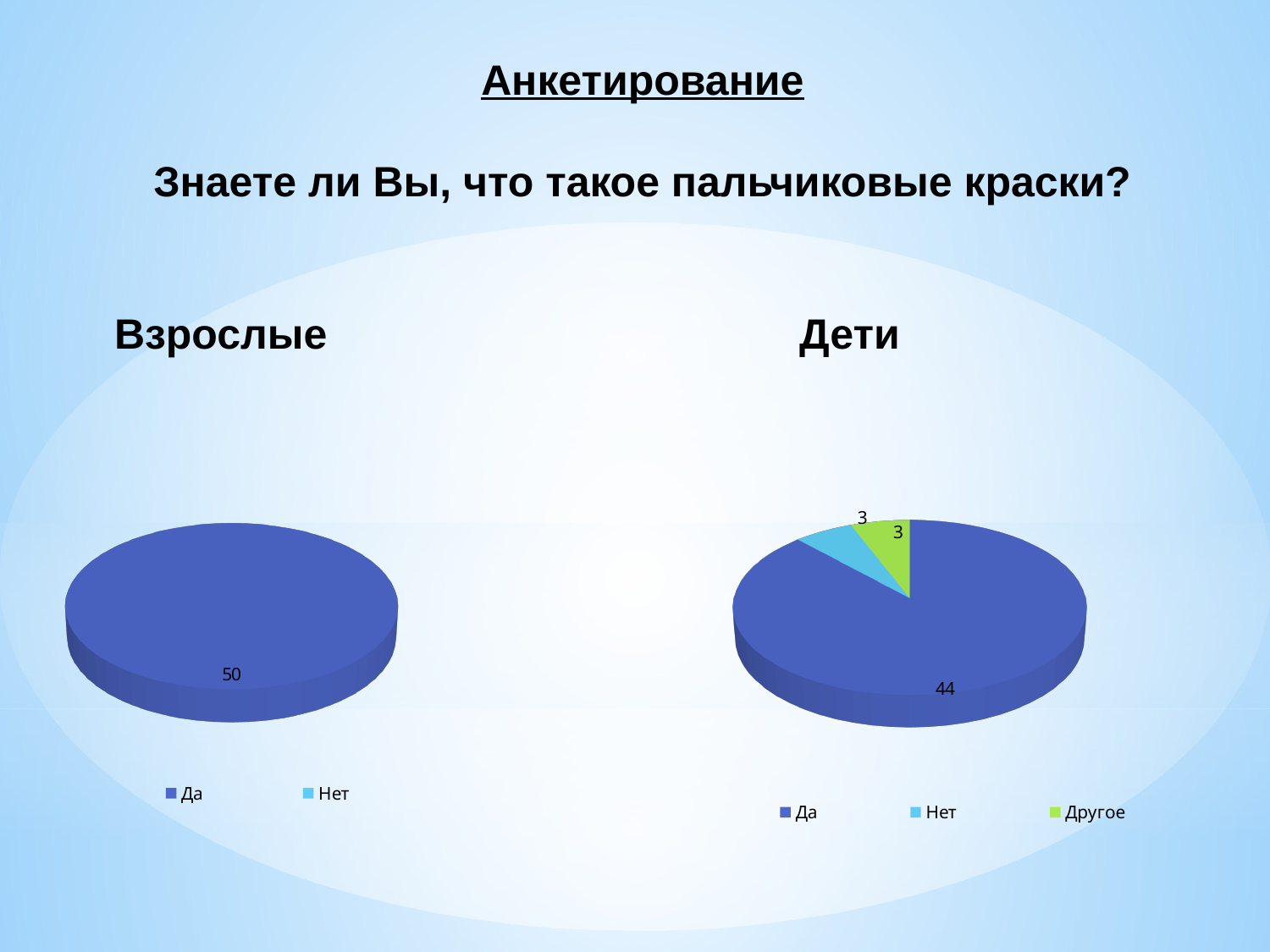
In the "Дети" chart, what is the difference between the values for "Да" and "Нет"? 41 In the "Дети" chart, what is the value for "Другое"? 3 How many entries does the legend of the "Дети" chart list? 3 In the "Дети" chart, what is the total of all slices? 50 In the "Дети" chart, what is the value for "Нет"? 3 What type of chart is the "Взрослые" chart? Pie chart In the "Взрослые" chart, what is the value for "Да"? 50 In the "Дети" chart, which is larger, the value for "Да" or the value for "Другое"? Да In the "Дети" chart, what is the value for "Да"? 44 In the "Дети" chart, which category has the largest slice? Да How many entries does the legend of the "Взрослые" chart list? 2 In the "Дети" chart, what share of the pie does "Да" represent? 88%